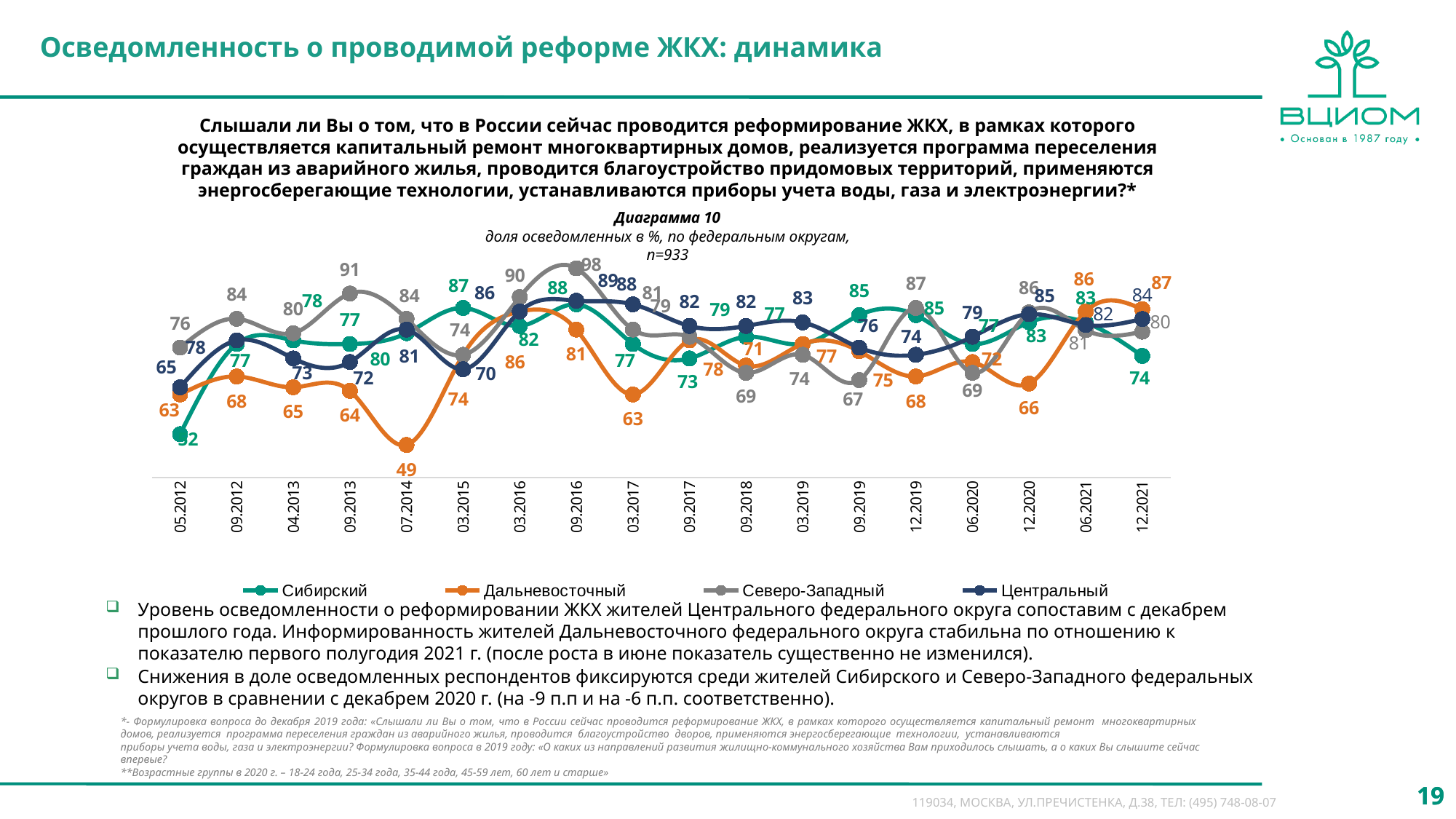
How many series does the chart legend list? 4 How many time points are shown on the x axis of the chart? 18 Which series has the highest value at 09.2016? Северо-Западный What is the value for Дальневосточный at 12.2021? 87 What sample size (n) is stated in the chart subtitle? n=933 What is the difference between the Дальневосточный values at 12.2021 and 05.2012? 24 What is the value for Северо-Западный at 09.2016? 98 Does the Дальневосточный series rise or fall from 12.2020 to 12.2021? rise What kind of chart is shown on the slide? line chart At 12.2021, which is larger: Дальневосточный or Сибирский? Дальневосточный At which time point does Дальневосточный reach its lowest value? 07.2014 What is the value for Сибирский at 05.2012? 52